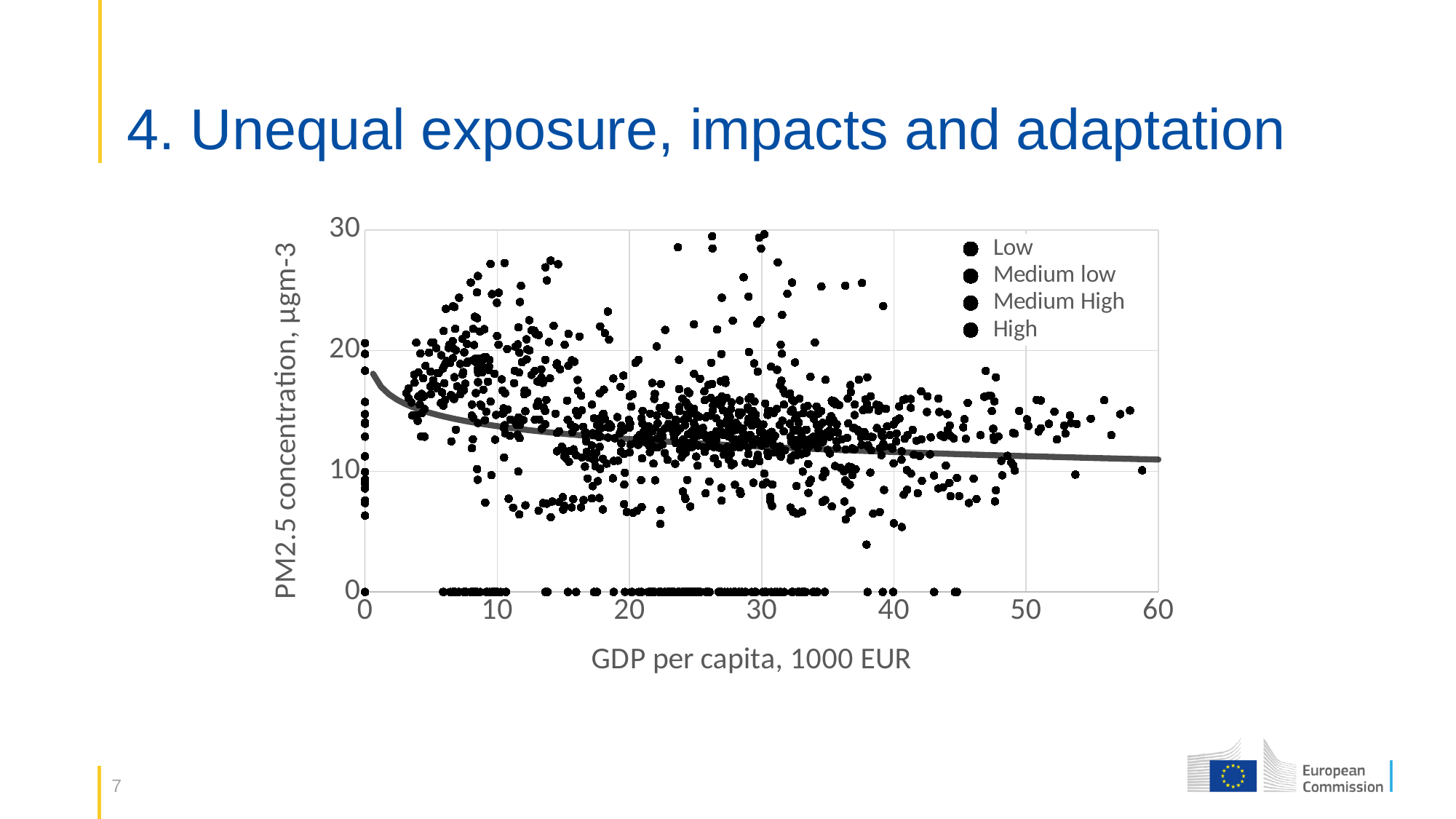
How many series does the chart's legend list? 4 Is the value of the trend line at a GDP per capita of 60 greater or less than 20? less What is the highest value shown on the x axis of the chart? 60 Is the value of the trend line at a GDP per capita of 0 greater or less than 20? less What is the highest value shown on the y axis of the chart? 30 Does the fitted trend line in the chart rise or fall as GDP per capita increases? fall What kind of chart is shown on the slide? scatter chart Is the value of the trend line at a GDP per capita of 0 greater or less than 10? greater What are the series names listed in the chart's legend? Low, Medium low, Medium High, High What is the title of the x axis of the chart? GDP per capita, 1000 EUR